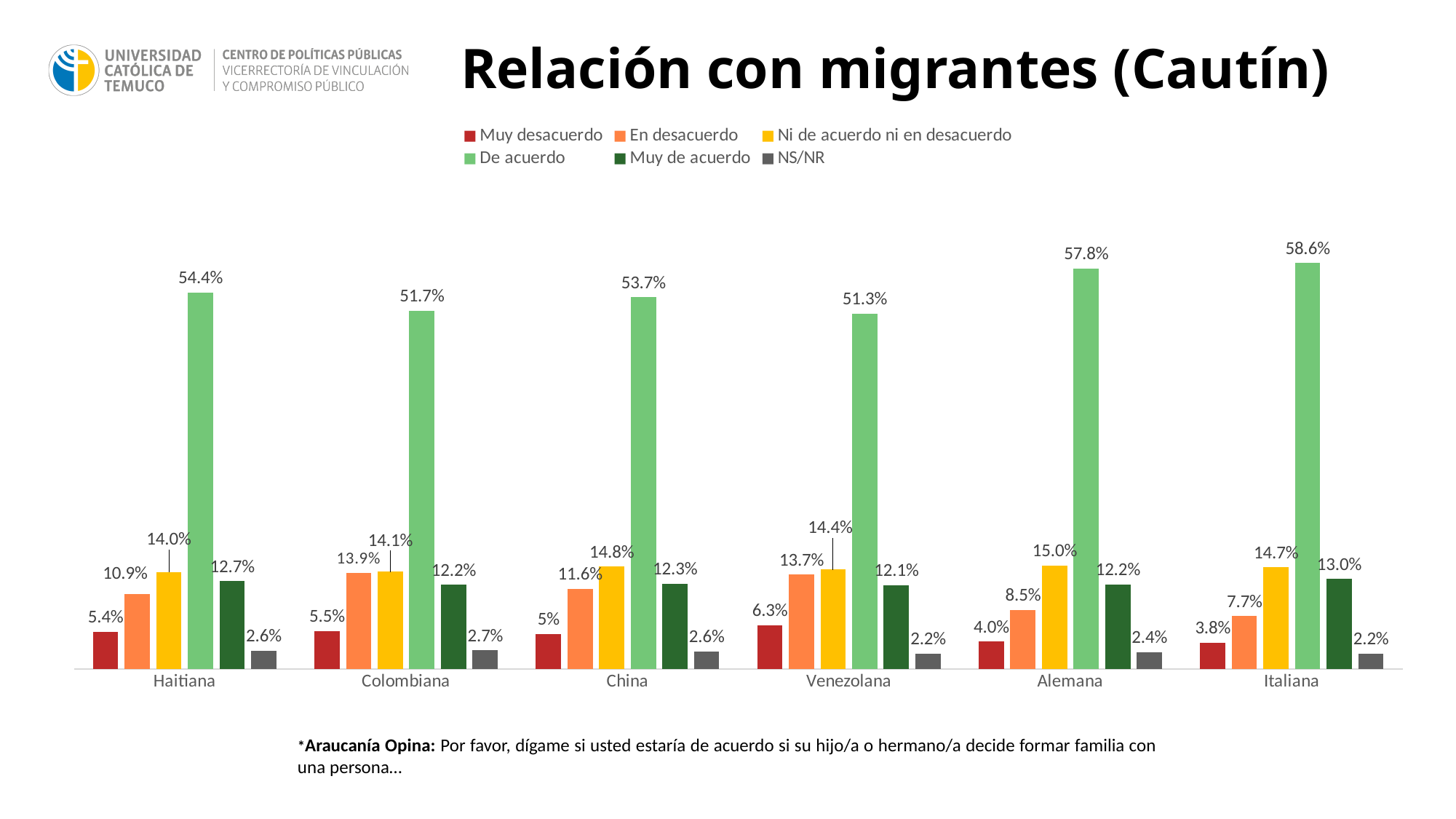
What is the title of the chart? Relación con migrantes (Cautín) How many series does the legend list? 6 What is the value for 'En desacuerdo' for Colombiana? 13.9% What is the value for 'De acuerdo' for Italiana? 58.6% What kind of chart is shown on the slide? Bar chart Which category has the highest 'De acuerdo' value? Italiana What is the difference between the 'De acuerdo' values for Alemana and Haitiana? 3.4% Which is larger: 'En desacuerdo' for Haitiana or 'En desacuerdo' for Alemana? Haitiana What is the value for 'NS/NR' for China? 2.6% Which category has the lowest 'De acuerdo' value? Venezolana How many categories are shown on the x axis? 6 What is the value for 'Muy desacuerdo' for Venezolana? 6.3%